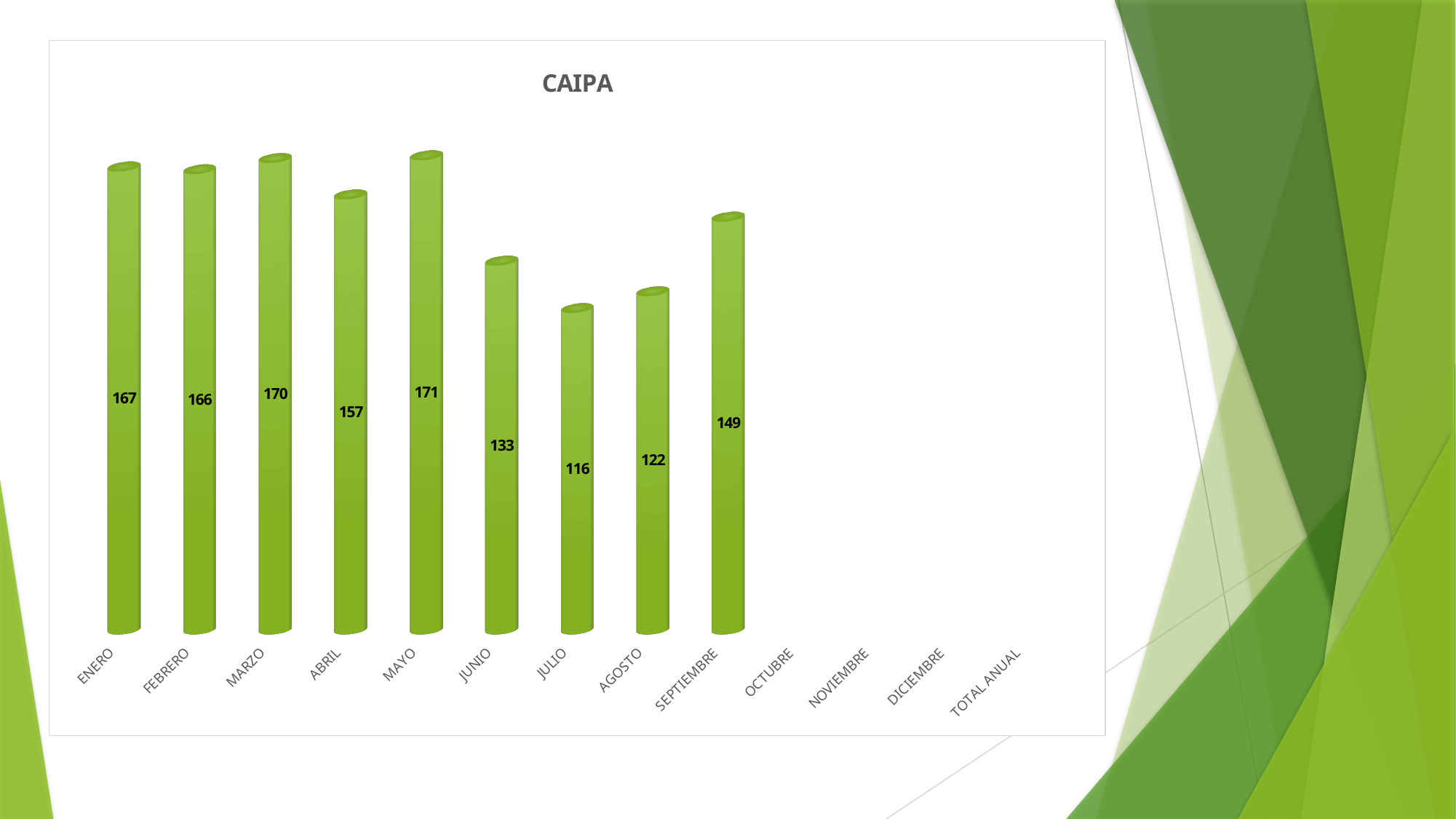
What is the value for MAYO? 171 Which month has the highest value? MAYO Which is larger, the value for FEBRERO or the value for SEPTIEMBRE? FEBRERO What is the value for SEPTIEMBRE? 149 Which month has the lowest value? JULIO How many months have a bar plotted on the chart? 9 What is the difference between the values for MARZO and AGOSTO? 48 What is the title of the chart? CAIPA What is the value for ABRIL? 157 What is the difference between the values for ENERO and JUNIO? 34 What kind of chart is shown? Bar chart What is the value for JULIO? 116